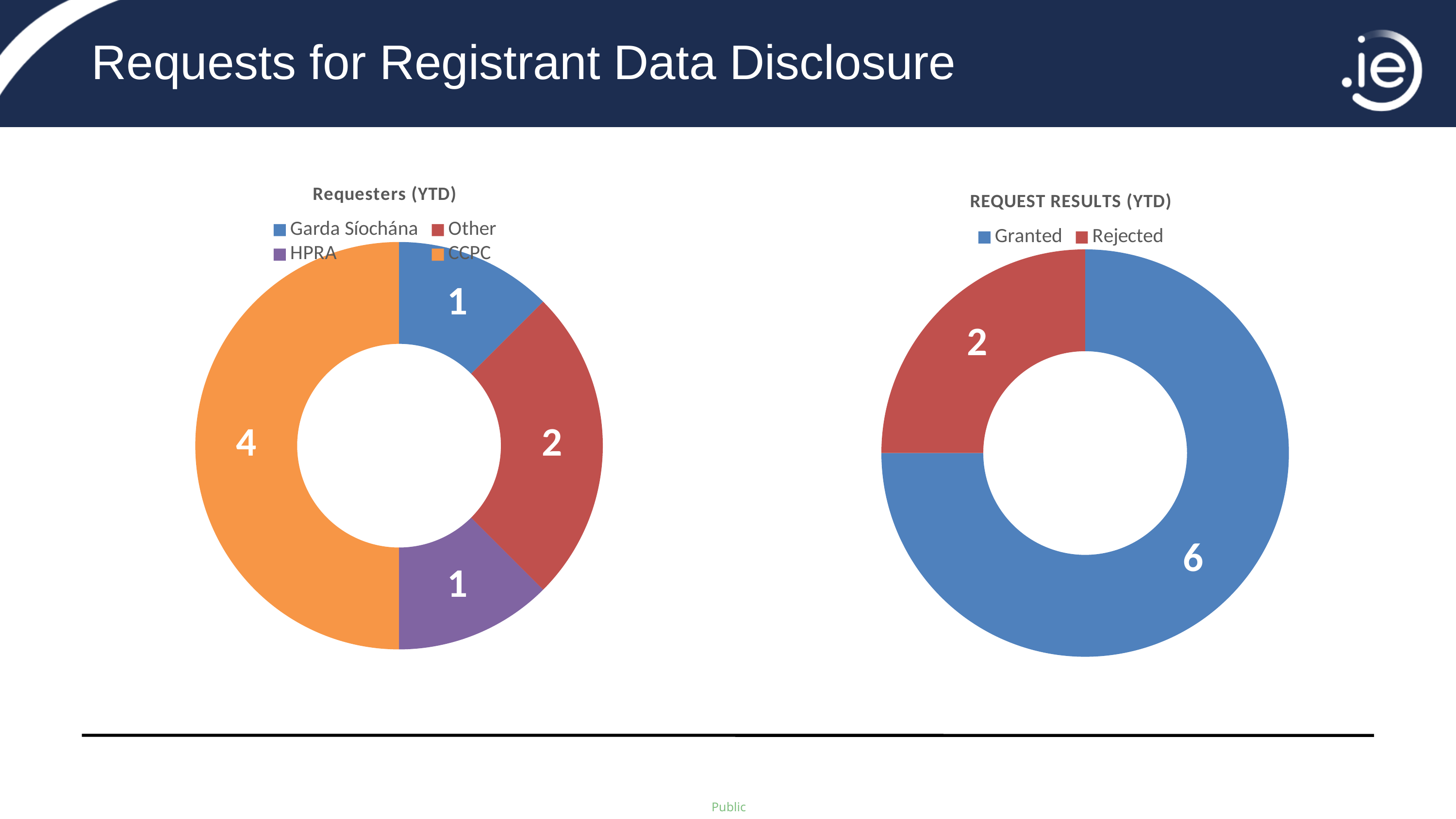
In the Requesters (YTD) chart, what is the value for Other? 2 In the REQUEST RESULTS (YTD) chart, what share of the total is Rejected? 25% In the Requesters (YTD) chart, which requester has the highest value? CCPC In the Requesters (YTD) chart, what is the value for CCPC? 4 In the REQUEST RESULTS (YTD) chart, what is the value for Rejected? 2 In the REQUEST RESULTS (YTD) chart, what is the value for Granted? 6 What kind of chart is the REQUEST RESULTS (YTD) chart? Doughnut (pie) chart In the REQUEST RESULTS (YTD) chart, which is larger, Granted or Rejected? Granted In the Requesters (YTD) chart, how many categories does the legend list? 4 In the Requesters (YTD) chart, what is the total of all slices? 8 In the Requesters (YTD) chart, what is the difference between the values for CCPC and Other? 2 In the Requesters (YTD) chart, what share of the total does CCPC represent? 50%